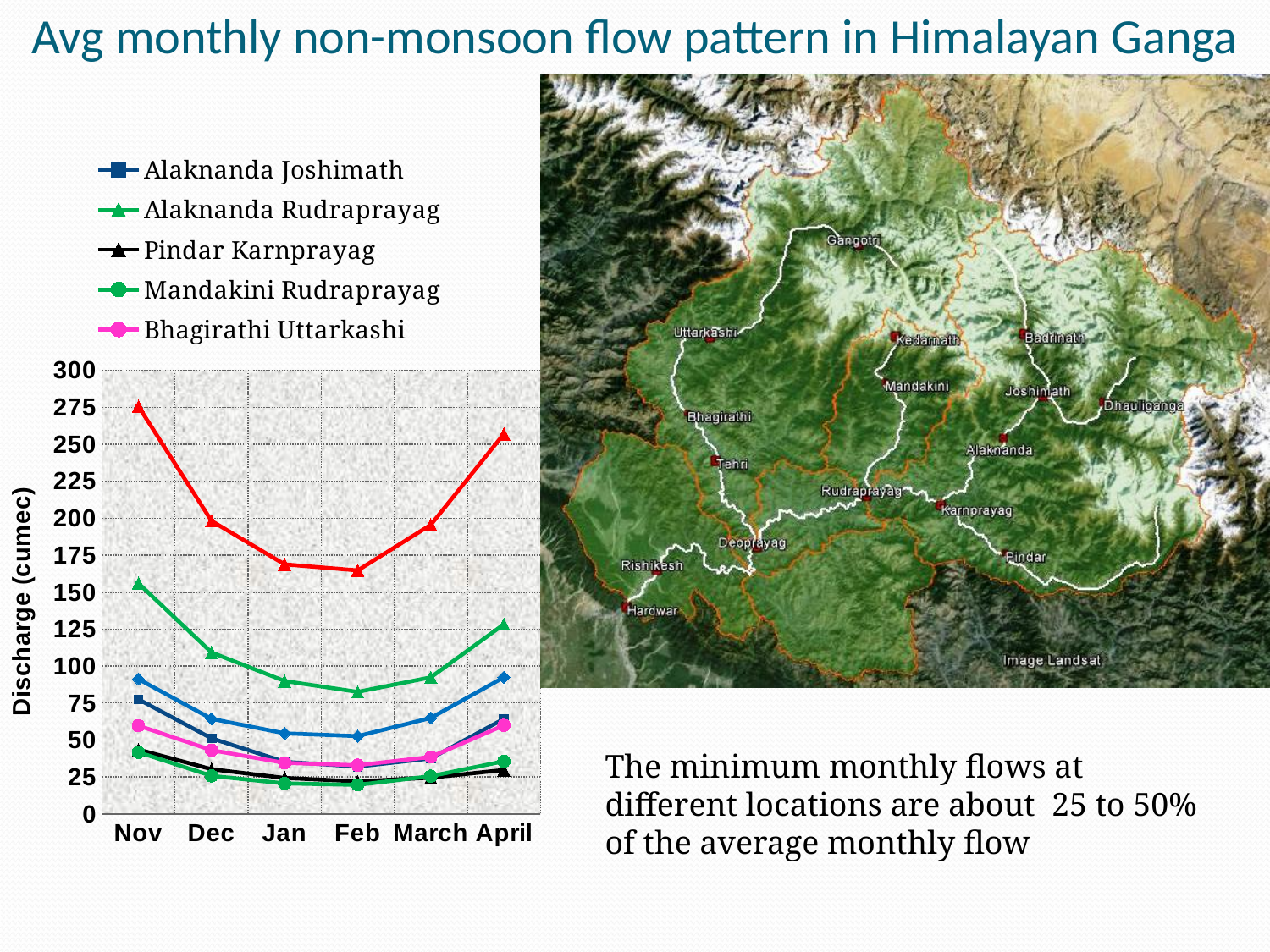
Is the value for Alaknanda Rudraprayag in Nov greater or less than 125? greater What is the label of the chart's y axis? Discharge (cumec) In which month is the Alaknanda Rudraprayag discharge highest? Nov Is the value for Alaknanda Rudraprayag in Feb greater or less than 100? less What kind of chart is shown on the slide? line chart Does the Alaknanda Rudraprayag discharge rise or fall from Nov to Feb? fall Which is larger in Nov, the discharge for Alaknanda Rudraprayag or for Alaknanda Joshimath? Alaknanda Rudraprayag How many series does the chart's legend list? 5 How many months are shown on the x axis of the chart? 6 Is the value for Mandakini Rudraprayag in Jan greater or less than 25? less